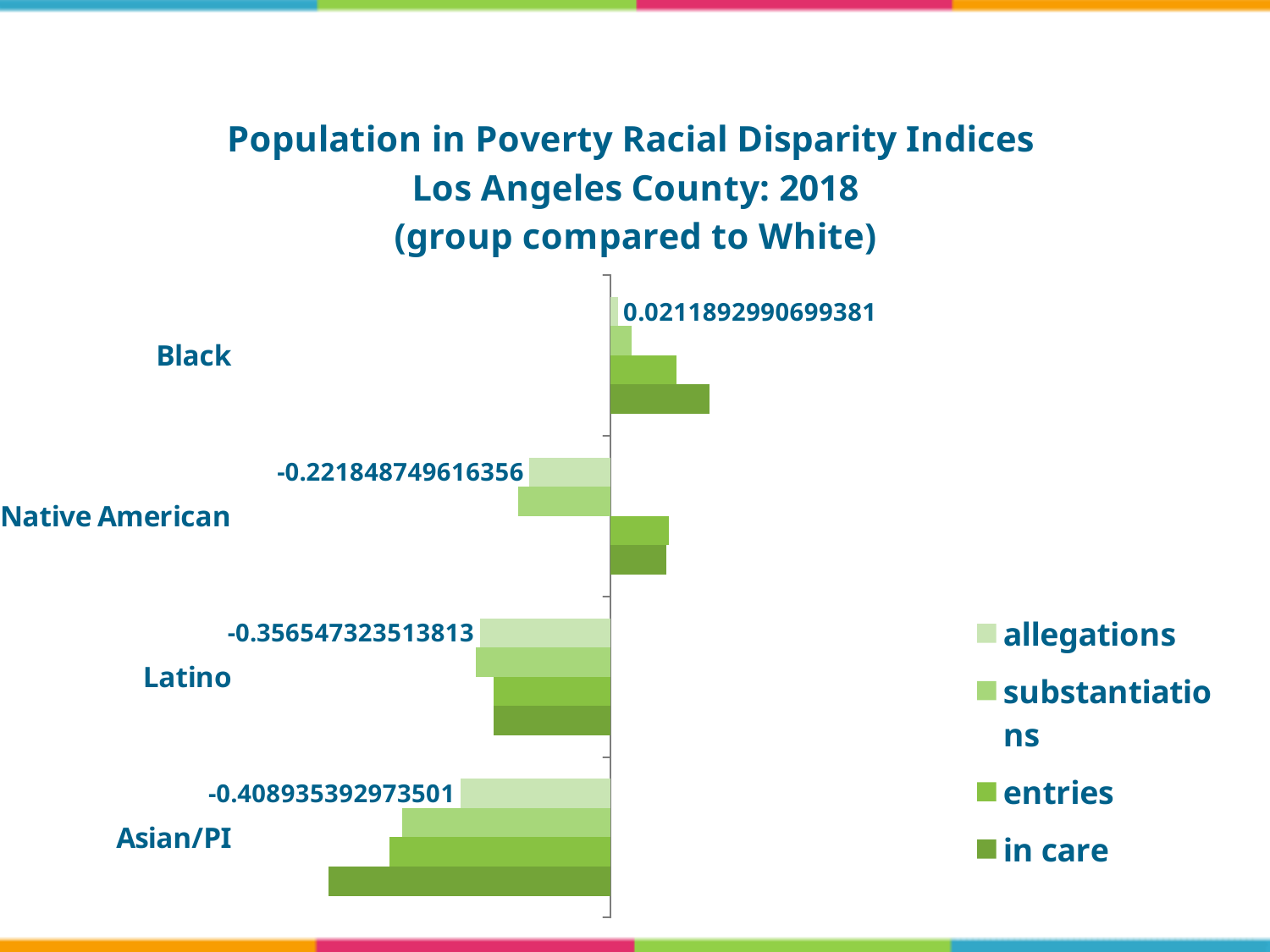
What kind of chart is shown? bar chart What is the allegations value for Latino? -0.356547323513813 Which is larger, the allegations value for Latino or for Native American? Native American How many groups are shown on the chart? 4 What is the allegations value for Native American? -0.221848749616356 Which group has the highest allegations value? Black Which series is shown in the darkest green in the legend? in care Which group has the longest negative in care bar? Asian/PI What is the allegations value for Asian/PI? -0.408935392973501 How many series does the legend list? 4 Which group has the lowest allegations value? Asian/PI What is the allegations value for Black? 0.0211892990699381